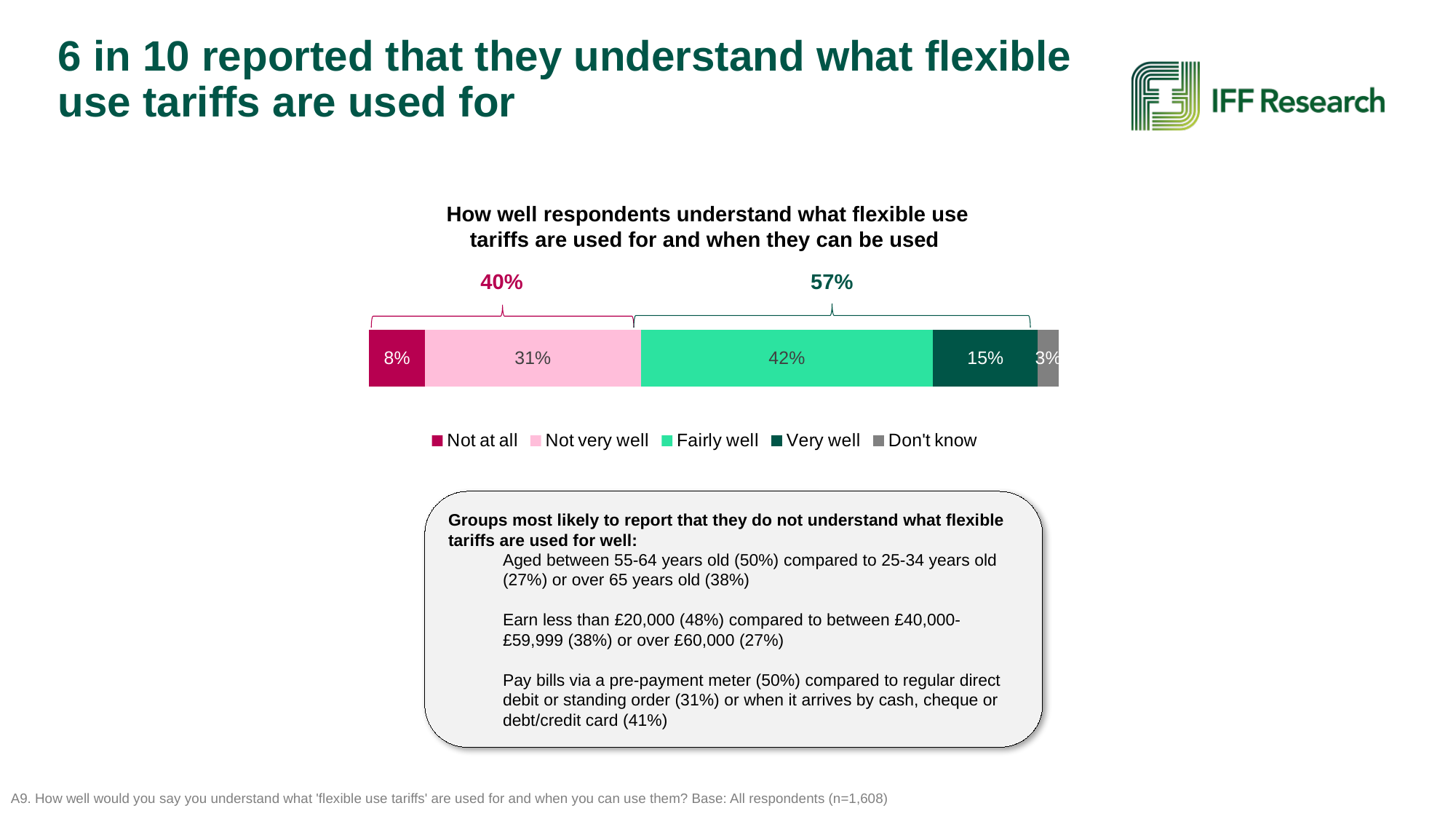
Which is larger, the share for 'Very well' or the share for 'Not at all'? Very well What combined percentage is shown by the bracket over the 'Not at all' and 'Not very well' segments? 40% Which response category has the largest share of respondents? Fairly well Which response category has the smallest share of respondents? Don't know What combined percentage is shown by the bracket over the 'Fairly well' and 'Very well' segments? 57% What is the difference in percentage points between 'Fairly well' and 'Not very well'? 11 What type of chart is shown on the slide? Stacked bar chart What percentage of respondents answered 'Not at all'? 8% What percentage of respondents answered 'Not very well'? 31% How many response categories does the legend list? 5 What percentage of respondents answered 'Very well'? 15% What percentage of respondents said they understand flexible use tariffs 'Fairly well'? 42%